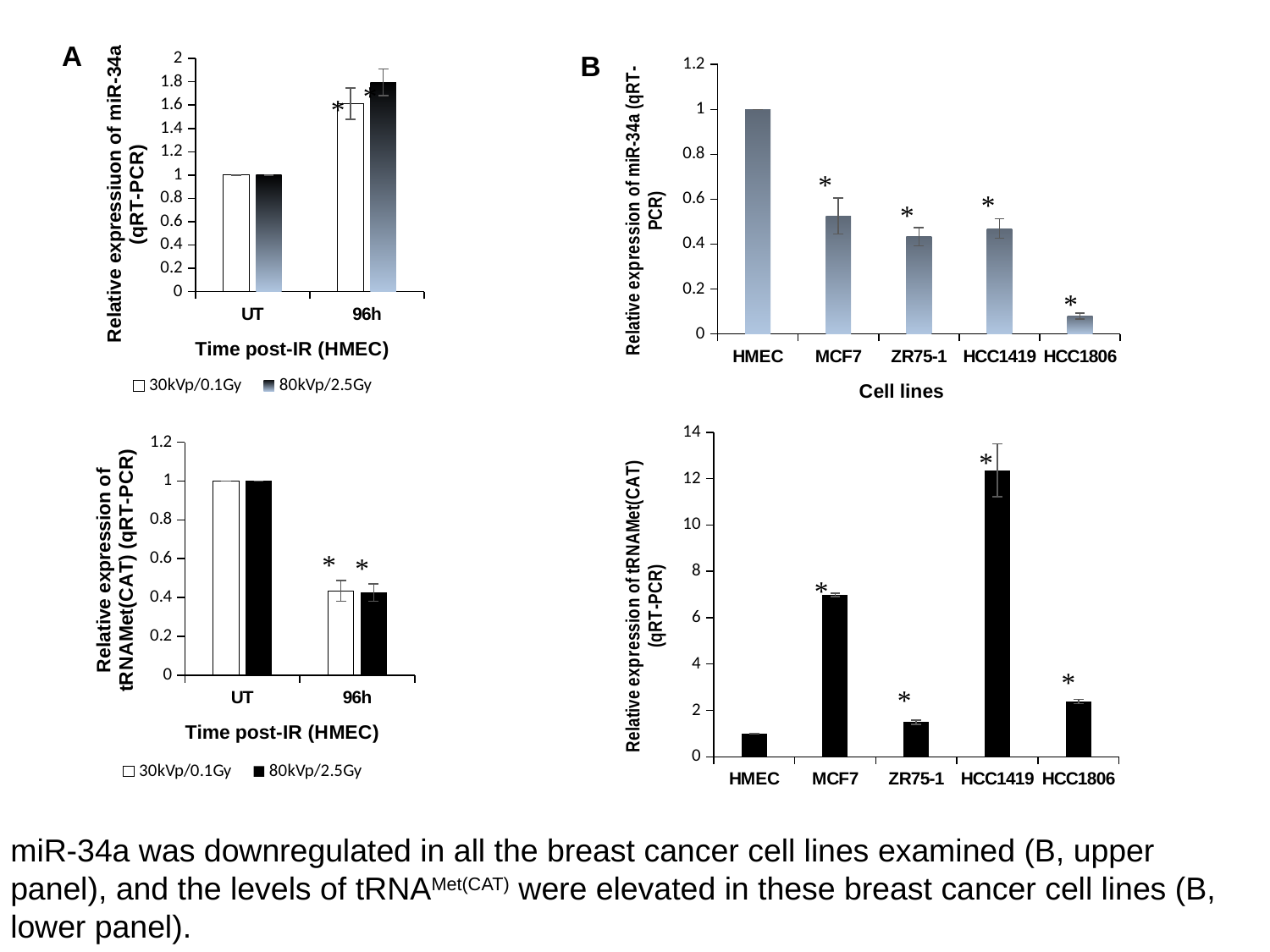
In the upper chart of panel A (miR-34a, Time post-IR), do the values rise or fall from UT to 96h? rise In the lower chart of panel B (tRNAMet(CAT) across cell lines), is the value for MCF7 greater or less than 6? greater In the lower chart of panel A (tRNAMet(CAT), Time post-IR), which is larger for the 30kVp/0.1Gy series: UT or 96h? UT What kind of chart is the upper chart in panel B (Relative expression of miR-34a across cell lines)? bar chart In the upper chart of panel B (miR-34a across cell lines), how many cell lines are shown on the x axis? 5 In the upper chart of panel B (miR-34a across cell lines), what is the value for HMEC? 1 In the lower chart of panel B (tRNAMet(CAT) across cell lines), which cell line has the highest value? HCC1419 What are the two legend entries in the lower chart of panel A (tRNAMet(CAT), Time post-IR)? 30kVp/0.1Gy and 80kVp/2.5Gy In the upper chart of panel B (miR-34a across cell lines), is the value for MCF7 greater or less than 0.4? greater In the upper chart of panel B (miR-34a across cell lines), which cell line has the lowest value? HCC1806 In the lower chart of panel B (tRNAMet(CAT) across cell lines), which is larger: MCF7 or HCC1806? MCF7 In the upper chart of panel A (miR-34a, Time post-IR), how many series does the legend list? 2